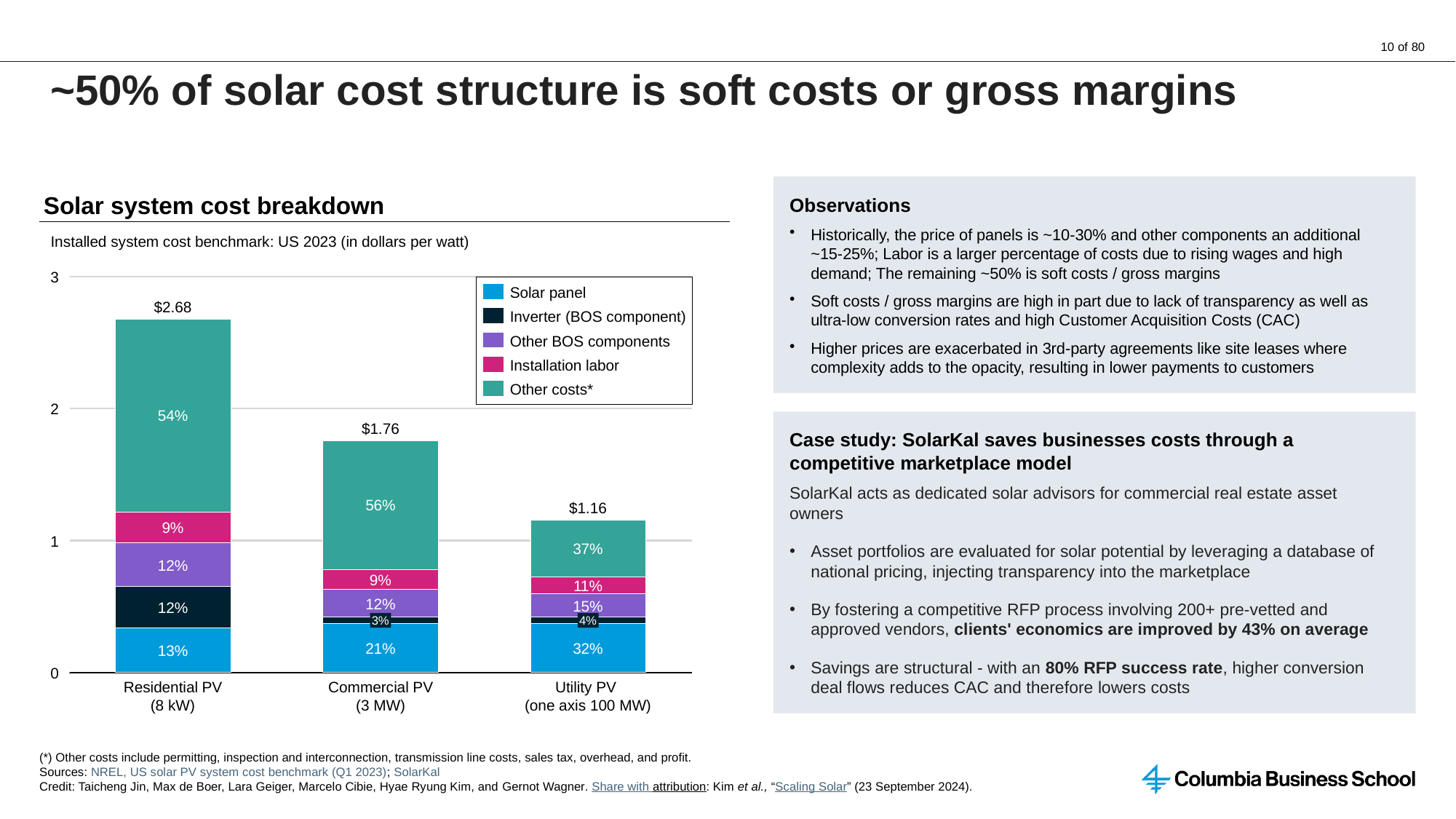
What share of the Residential PV (8 kW) cost is Installation labor? 9% What is the total installed system cost shown for Utility PV (one axis 100 MW)? $1.16 What share of the Commercial PV (3 MW) cost is Other costs*? 56% What share of the Utility PV (one axis 100 MW) cost is Solar panel? 32% How many categories are shown on the x axis of the chart? 3 What is the total installed system cost shown for Residential PV (8 kW)? $2.68 What is the difference between the total cost for Residential PV (8 kW) and Utility PV (one axis 100 MW)? $1.52 Which category has the lowest total installed system cost? Utility PV (one axis 100 MW) How many series does the legend list? 5 Which category has the highest total installed system cost? Residential PV (8 kW) Which is larger: the Solar panel share for Commercial PV (3 MW) or for Utility PV (one axis 100 MW)? Utility PV (one axis 100 MW) What kind of chart is shown on the slide? Stacked bar chart